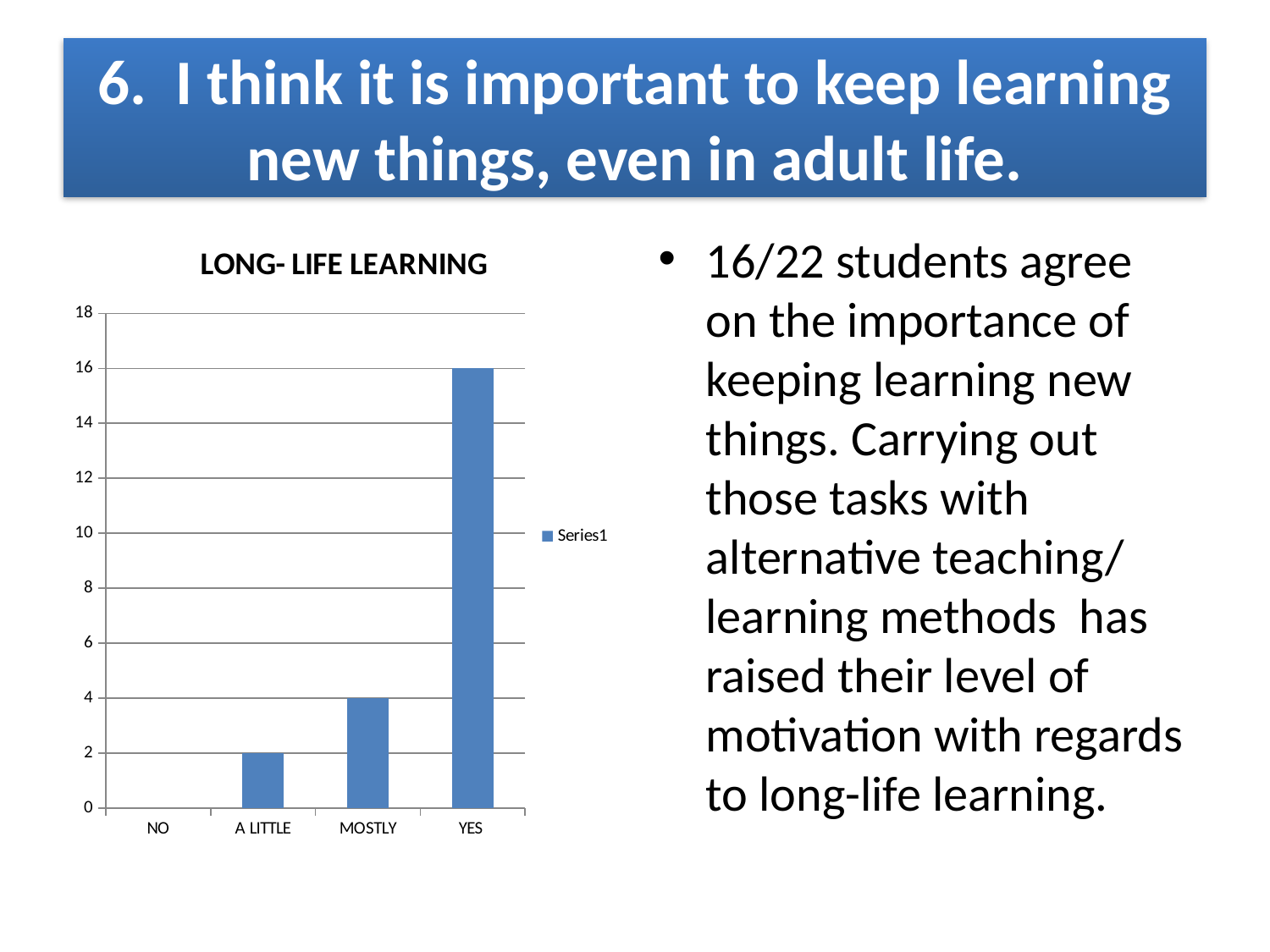
What type of chart is shown on the slide? bar chart What is the title of the chart? LONG- LIFE LEARNING What is the value for A LITTLE in the chart? 2 Which category has the lowest value in the chart? NO Is the value for YES greater or less than 10? greater What is the value for MOSTLY in the chart? 4 How many series does the chart legend list? 1 Which category has the highest value in the chart? YES How many categories are shown on the x axis of the chart? 4 What is the difference between the values for YES and MOSTLY? 12 What is the value for YES in the chart? 16 Which is larger, the value for MOSTLY or the value for A LITTLE? MOSTLY